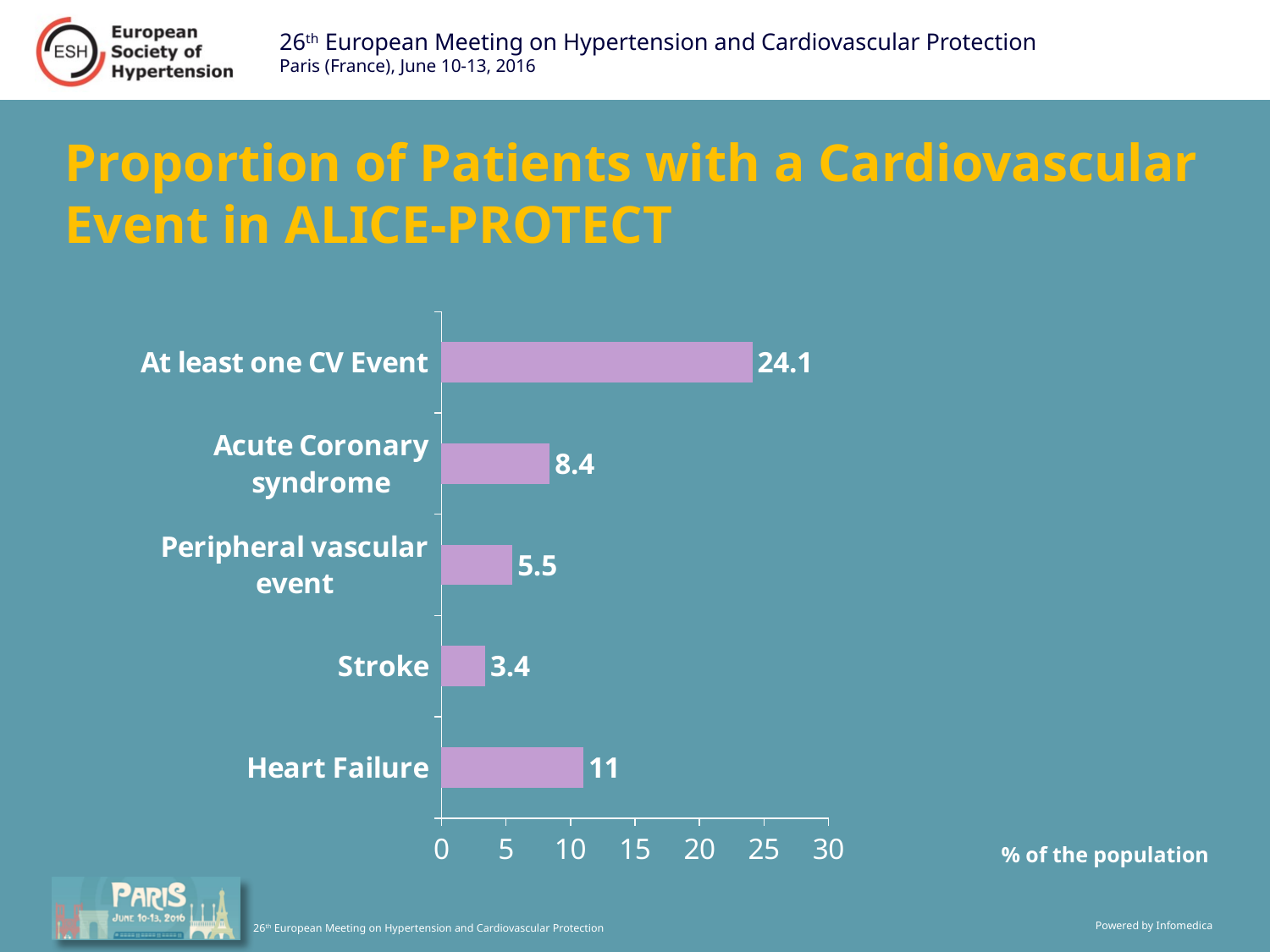
What is the value for At least one CV Event? 24.1 What is the value for Stroke? 3.4 What is the value for Peripheral vascular event? 5.5 Which category has the lowest value? Stroke What kind of chart is shown on the slide? Bar chart How many categories are shown in the chart? 5 Which is larger, the value for Acute Coronary syndrome or the value for Heart Failure? Heart Failure What is the value for Heart Failure? 11 Which category has the highest value? At least one CV Event What is the label of the horizontal axis? % of the population What is the difference between the values for At least one CV Event and Heart Failure? 13.1 What is the value for Acute Coronary syndrome? 8.4